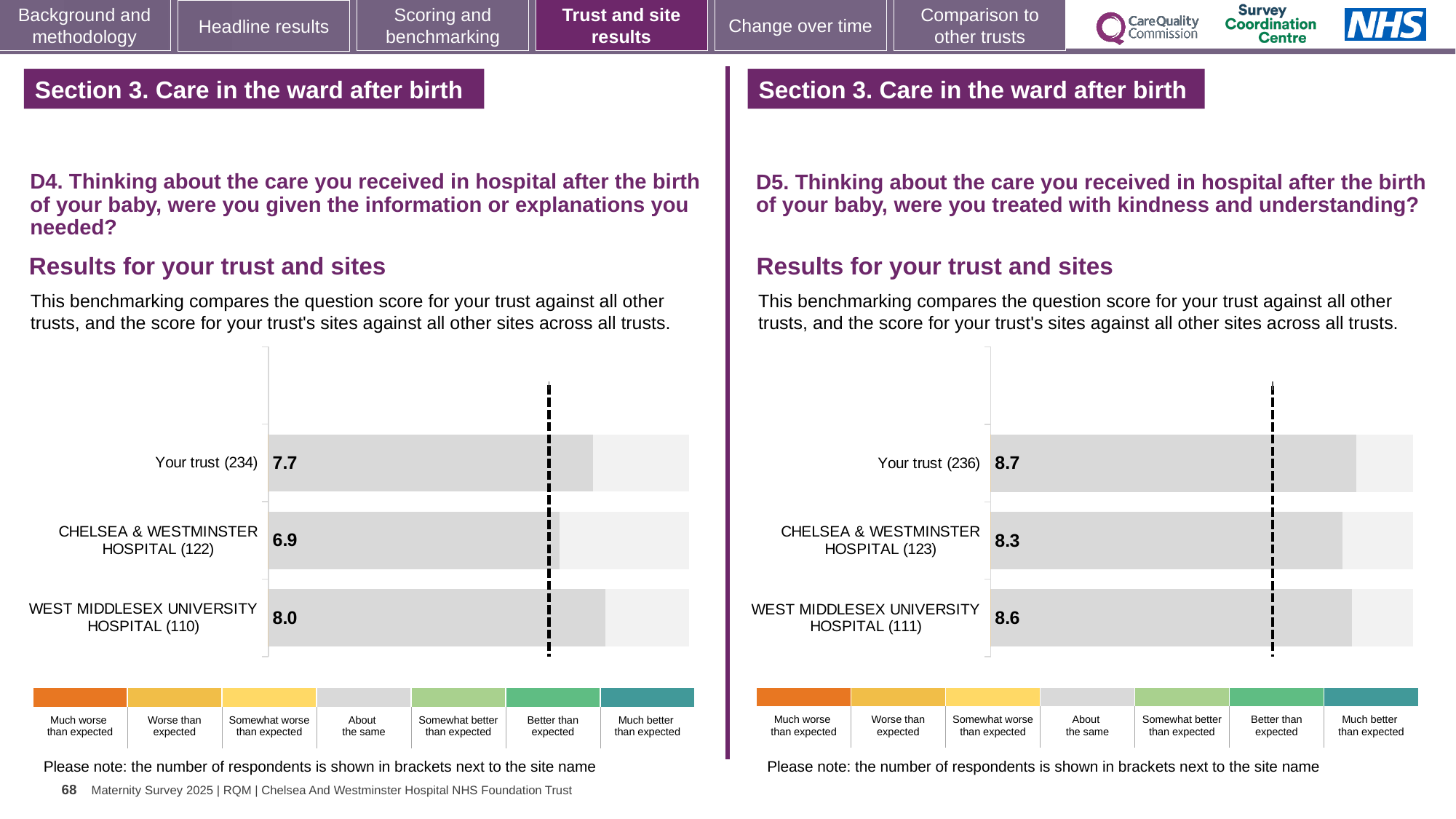
In the D5 chart on the right, what is the difference between the scores for Your trust and Chelsea & Westminster Hospital? 0.4 In the D4 chart on the left, how many respondents are shown in brackets for Your trust? 234 In the D5 chart on the right, which site or trust has the lowest score? Chelsea & Westminster Hospital In the D4 chart on the left, what is the score for Chelsea & Westminster Hospital? 6.9 In the D4 chart on the left, what is the difference between the scores for West Middlesex University Hospital and Chelsea & Westminster Hospital? 1.1 In the D4 chart on the left, which site or trust has the highest score? West Middlesex University Hospital In the D5 chart on the right, what is the score for Your trust? 8.7 In the D4 chart on the left, which site or trust has the lowest score? Chelsea & Westminster Hospital What type of chart is used in the D4 chart on the left? Bar chart In the D4 chart on the left, what is the score for Your trust? 7.7 In the D5 chart on the right, what is the score for West Middlesex University Hospital? 8.6 In the D5 chart on the right, how many bars are plotted? 3